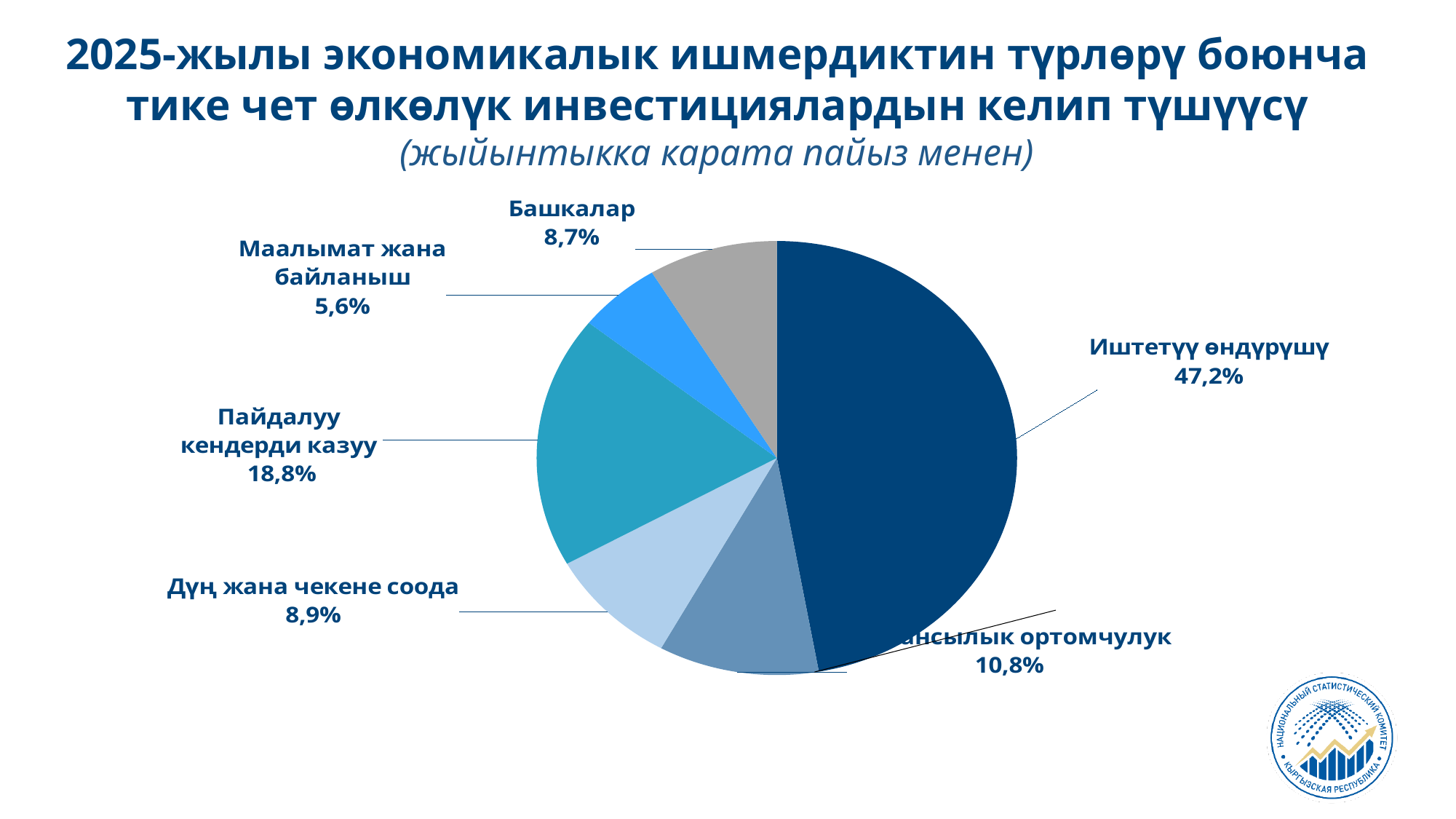
What share is shown for Башкалар? 8,7% What percentage is given for Дүң жана чекене соода? 8,9% What share of the pie does Иштетүү өндүрүшү account for? 47,2% Which is larger, the share for Пайдалуу кендерди казуу or the share for Башкалар? Пайдалуу кендерди казуу What value is labelled for Маалымат жана байланыш? 5,6% By how many percentage points does Иштетүү өндүрүшү exceed Пайдалуу кендерди казуу? 28,4 percentage points Which category has the smallest slice of the pie? Маалымат жана байланыш What kind of chart is shown on the slide? pie chart How many slices does the pie chart have? 6 Which category has the largest slice of the pie? Иштетүү өндүрүшү What percentage is shown for Пайдалуу кендерди казуу? 18,8% Is the share for Иштетүү өндүрүшү greater or less than 50%? less